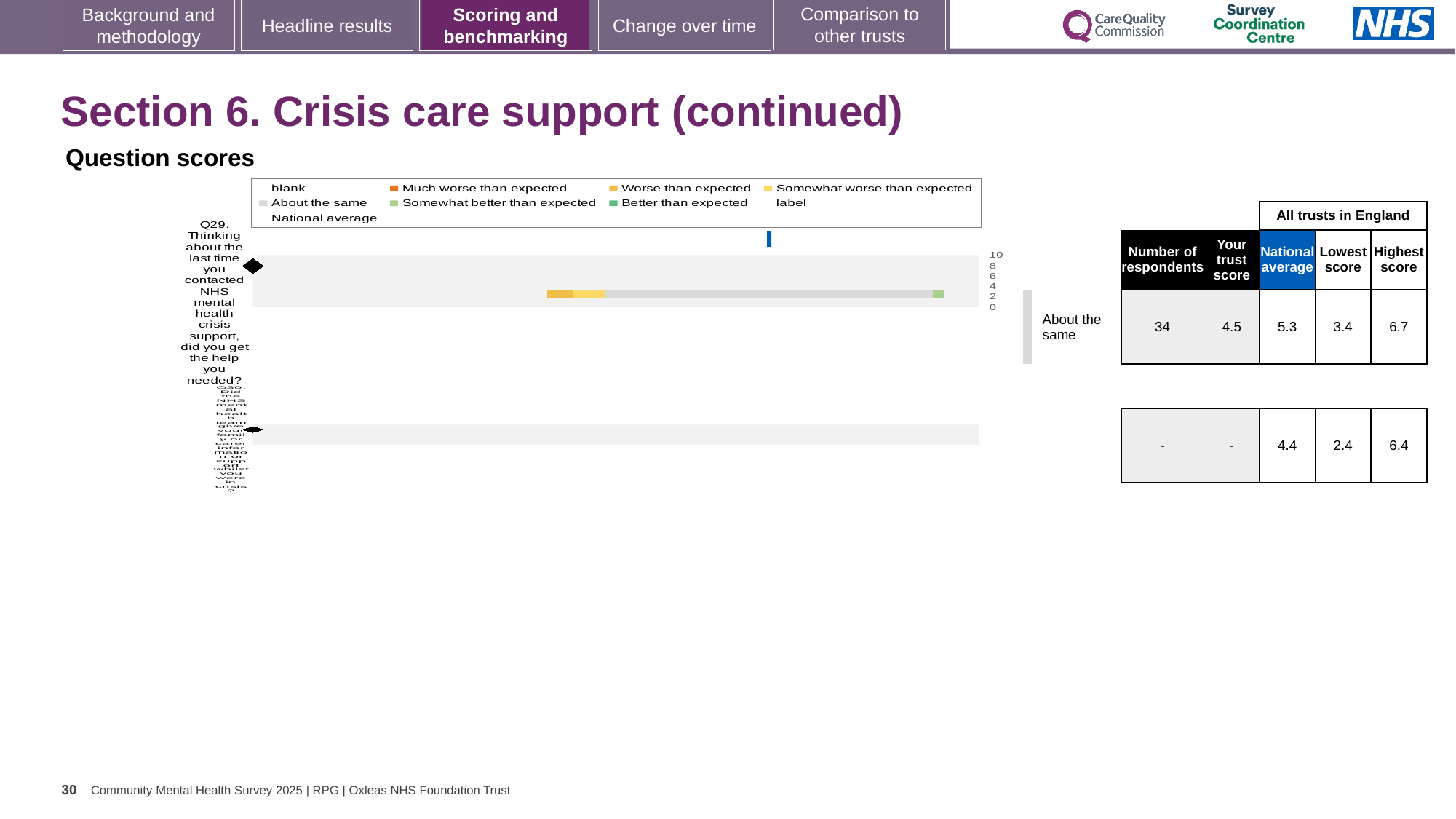
What is the national average for Q29? 5.3 What is the lowest score across all trusts in England for Q30? 2.4 Which is larger for Q29: the trust score or the national average? national average Which legend entry is shown in orange in the question scores chart? Much worse than expected How many questions (categories) are plotted in the question scores chart? 2 What benchmark label is shown for Q29 next to the chart? About the same What kind of chart is used to show the question scores on this slide? bar chart How many respondents answered Q29? 34 What is the difference between the highest and lowest scores for Q29 across all trusts in England? 3.3 What is the trust score for Q29 shown in the table next to the chart? 4.5 What is the national average for Q30? 4.4 What is the highest score across all trusts in England for Q29? 6.7